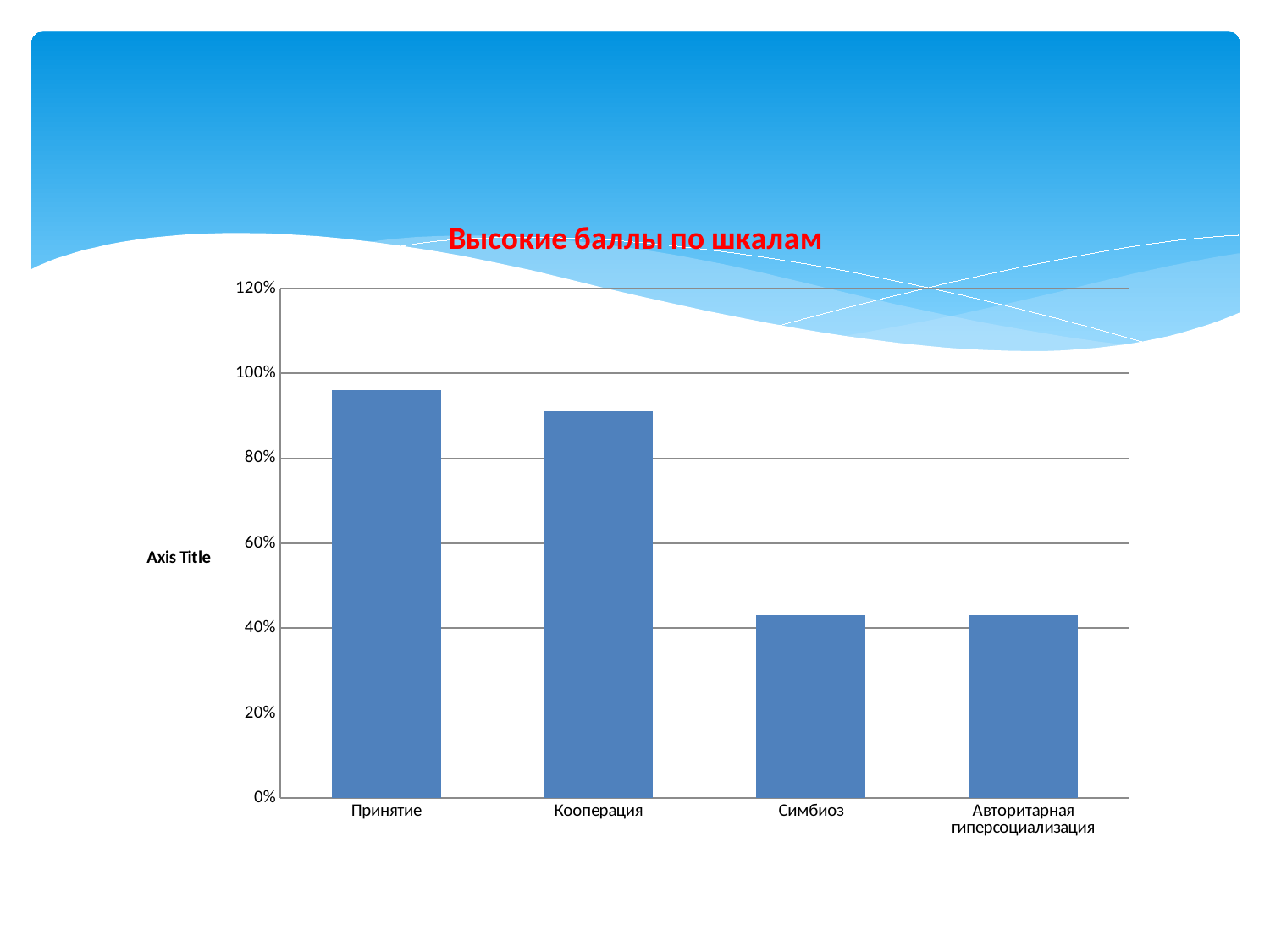
Which is larger, the value for Кооперация or the value for Симбиоз? Кооперация Which is larger, the value for Принятие or the value for Кооперация? Принятие Is the value for Авторитарная гиперсоциализация greater or less than 40%? greater What is the title of the chart? Высокие баллы по шкалам Is the value for Симбиоз greater or less than 60%? less Is the value for Принятие greater or less than 80%? greater What is the label shown on the vertical axis of the chart? Axis Title How many categories are shown on the x axis of the chart? 4 Which category has the highest bar in the chart? Принятие What kind of chart is shown on the slide? bar chart